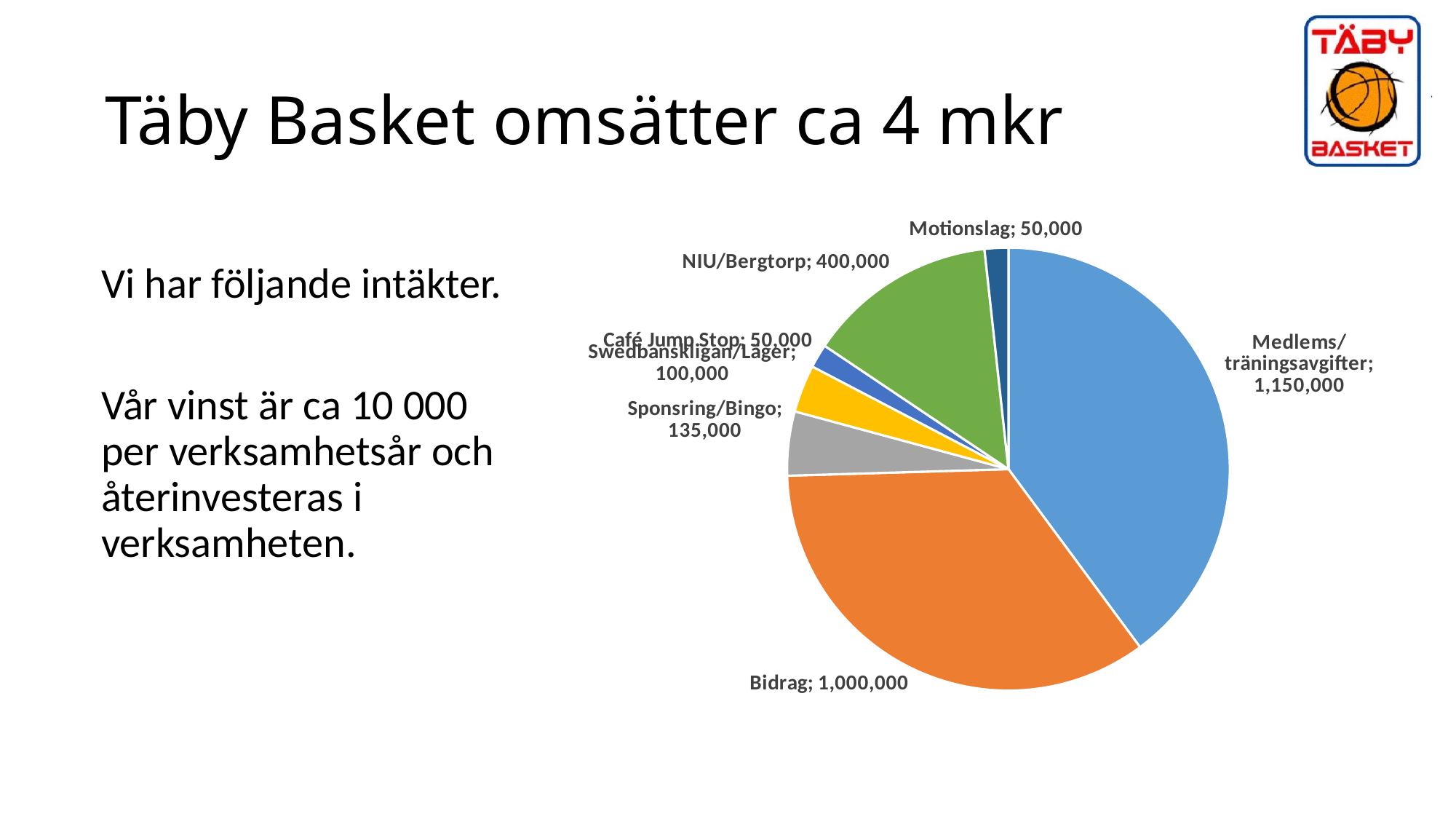
What is the value for Sponsring/Bingo in the pie chart? 135,000 Which category has the largest slice in the pie chart? Medlems/träningsavgifter What is the value for Bidrag in the pie chart? 1,000,000 Which is larger, NIU/Bergtorp or Sponsring/Bingo? NIU/Bergtorp What kind of chart is shown on the slide? Pie chart What is the value for Motionslag in the pie chart? 50,000 How many slices does the pie chart have? 7 What is the difference between Medlems/träningsavgifter and Bidrag? 150,000 What is the difference between NIU/Bergtorp and Swedbanksligan/Lager? 300,000 What is the value for NIU/Bergtorp in the pie chart? 400,000 What is the value for Medlems/träningsavgifter in the pie chart? 1,150,000 What colour is the Bidrag slice in the pie chart? Orange